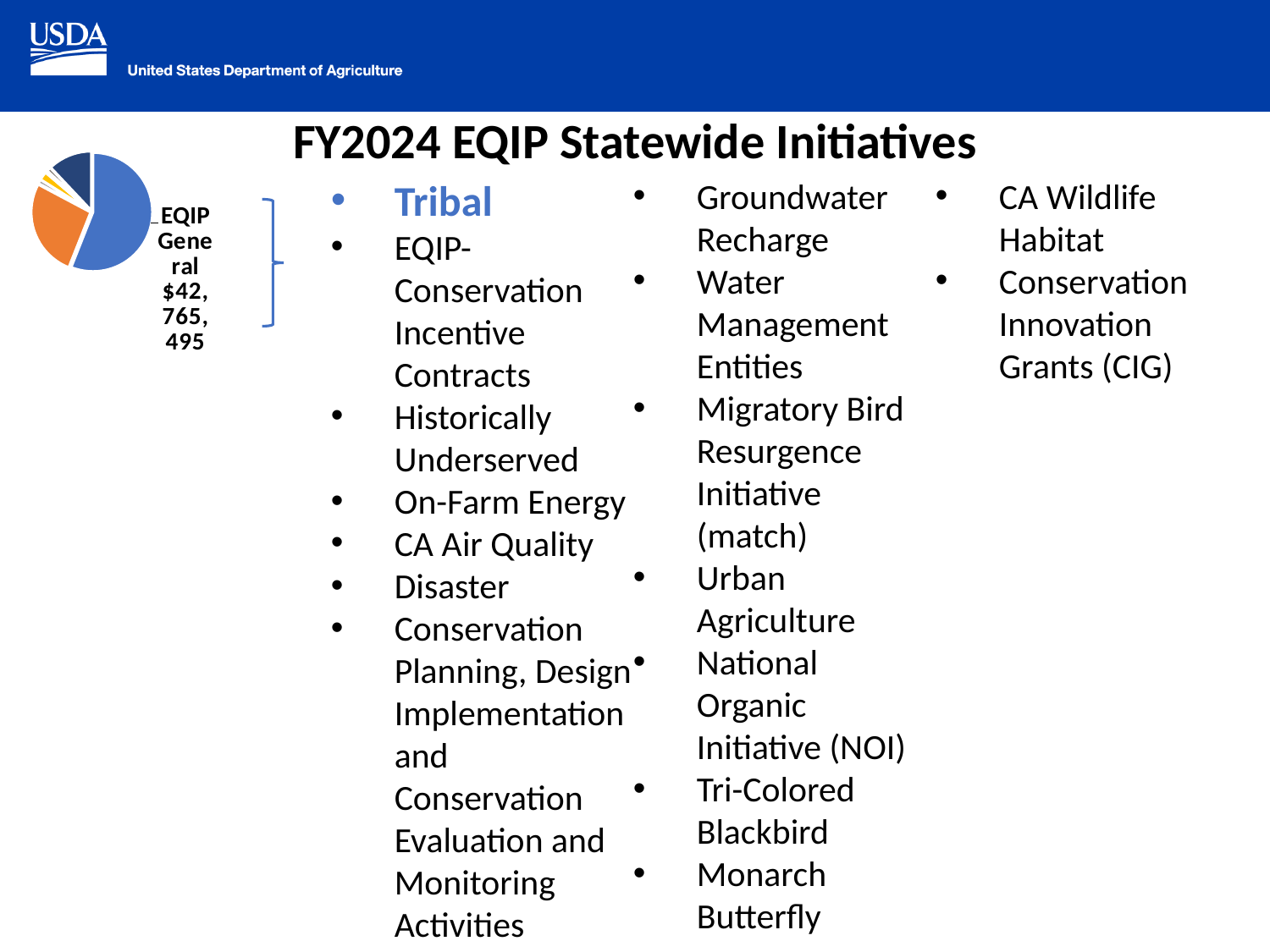
What kind of chart is shown on the slide? pie chart Which slice of the pie chart has a data label? EQIP General What value is shown for the EQIP General slice of the pie chart? $42,765,495 What colour is the EQIP General slice in the pie chart? blue Which slice of the pie chart is the largest? EQIP General